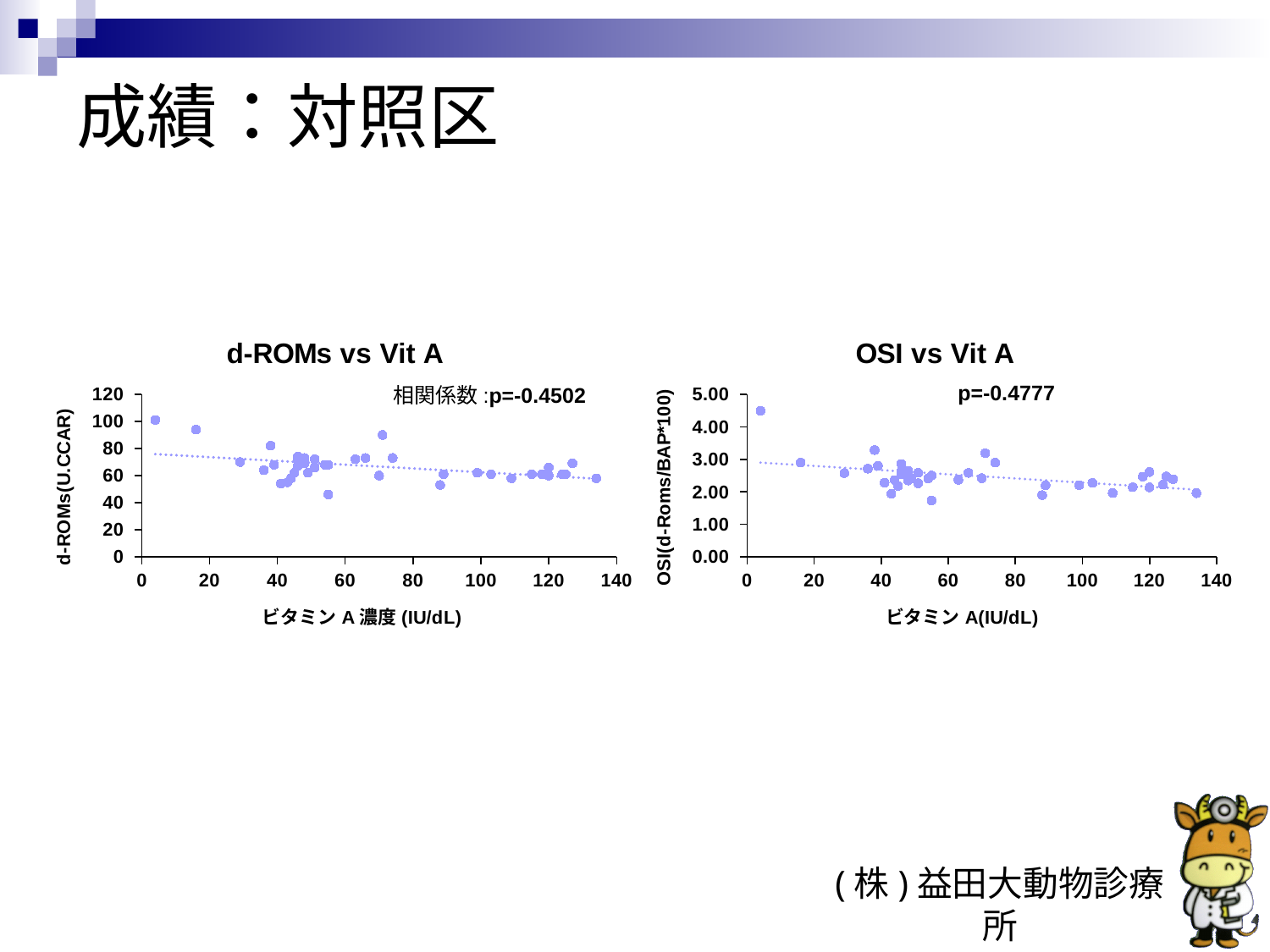
What correlation coefficient is printed on the "OSI vs Vit A" chart? p=-0.4777 What kind of chart is the "OSI vs Vit A" chart? scatter chart In the "d-ROMs vs Vit A" chart, which has the higher d-ROMs value: the leftmost point (vitamin A near 4) or the rightmost point (vitamin A near 135)? the leftmost point What correlation coefficient is printed on the "d-ROMs vs Vit A" chart? p=-0.4502 In the "OSI vs Vit A" chart, is the OSI value of the leftmost point (at vitamin A near 4) greater or less than 4.00? greater What kind of chart is the "d-ROMs vs Vit A" chart? scatter chart In the "OSI vs Vit A" chart, is the OSI value of the rightmost point (at vitamin A near 135) greater or less than 3.00? less In the "d-ROMs vs Vit A" chart, do the d-ROMs values tend to rise or fall as vitamin A concentration increases? fall In the "OSI vs Vit A" chart, do the OSI values tend to rise or fall as vitamin A increases? fall In the "d-ROMs vs Vit A" chart, is the d-ROMs value of the rightmost point (at vitamin A near 135) greater or less than 80? less In the "OSI vs Vit A" chart, which has the higher OSI value: the leftmost point (vitamin A near 4) or the rightmost point (vitamin A near 135)? the leftmost point